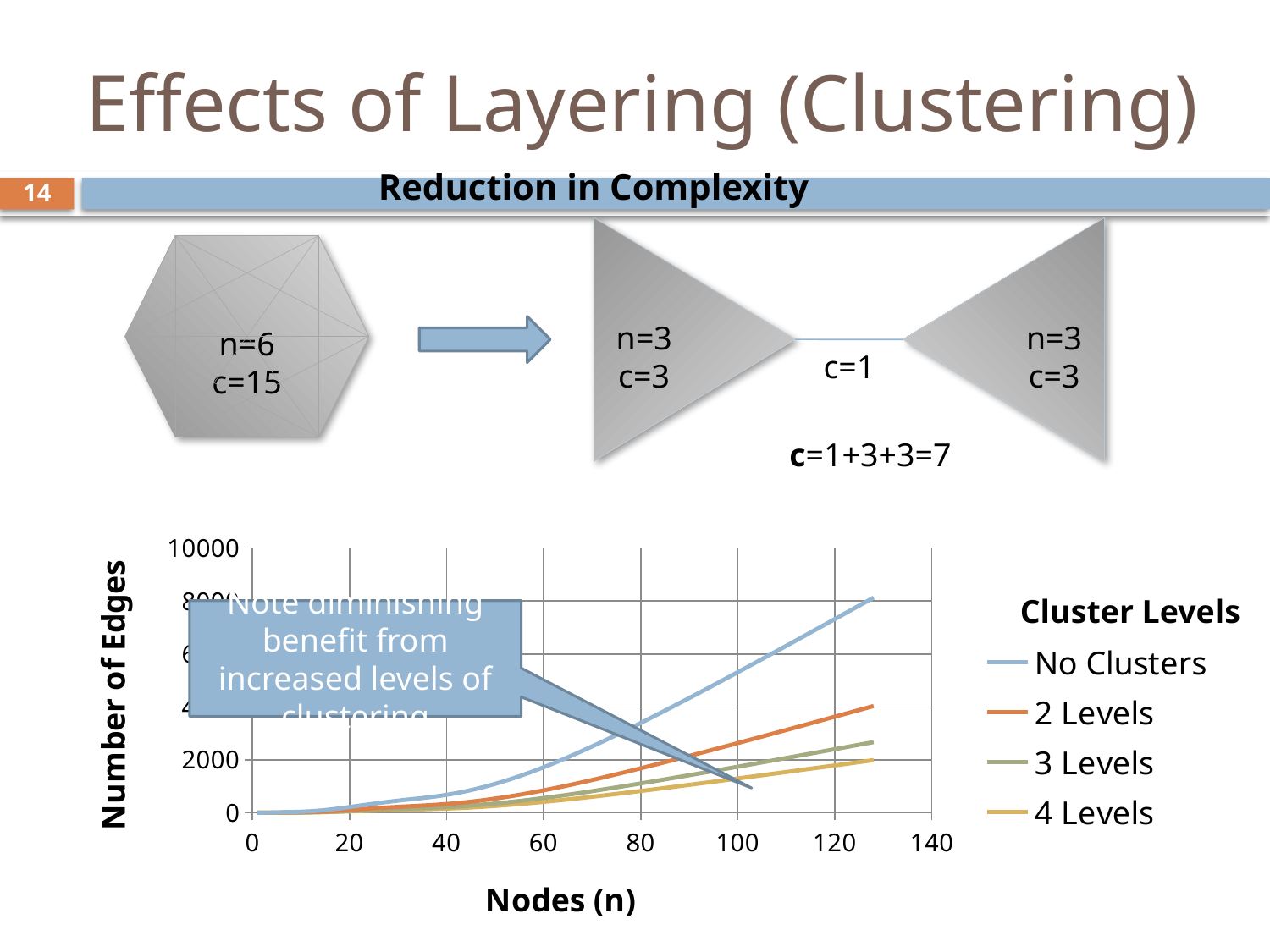
Is the value for 4 Levels at 120 nodes greater or less than 4000? less Which series reaches the highest number of edges at the right end of the chart? No Clusters Which series has the lowest number of edges at the right end of the chart? 4 Levels What is the label of the chart's x axis? Nodes (n) Is the value for 2 Levels at 100 nodes greater or less than 6000? less Do the values for the No Clusters series rise or fall as the number of nodes increases? rise Is the value for No Clusters at 120 nodes greater or less than 6000? greater What is the title of the chart's legend? Cluster Levels How many series does the chart legend list? 4 What kind of chart is shown on the slide? line chart At 120 nodes, which series has more edges: 2 Levels or 4 Levels? 2 Levels At 120 nodes, which series has more edges: No Clusters or 2 Levels? No Clusters